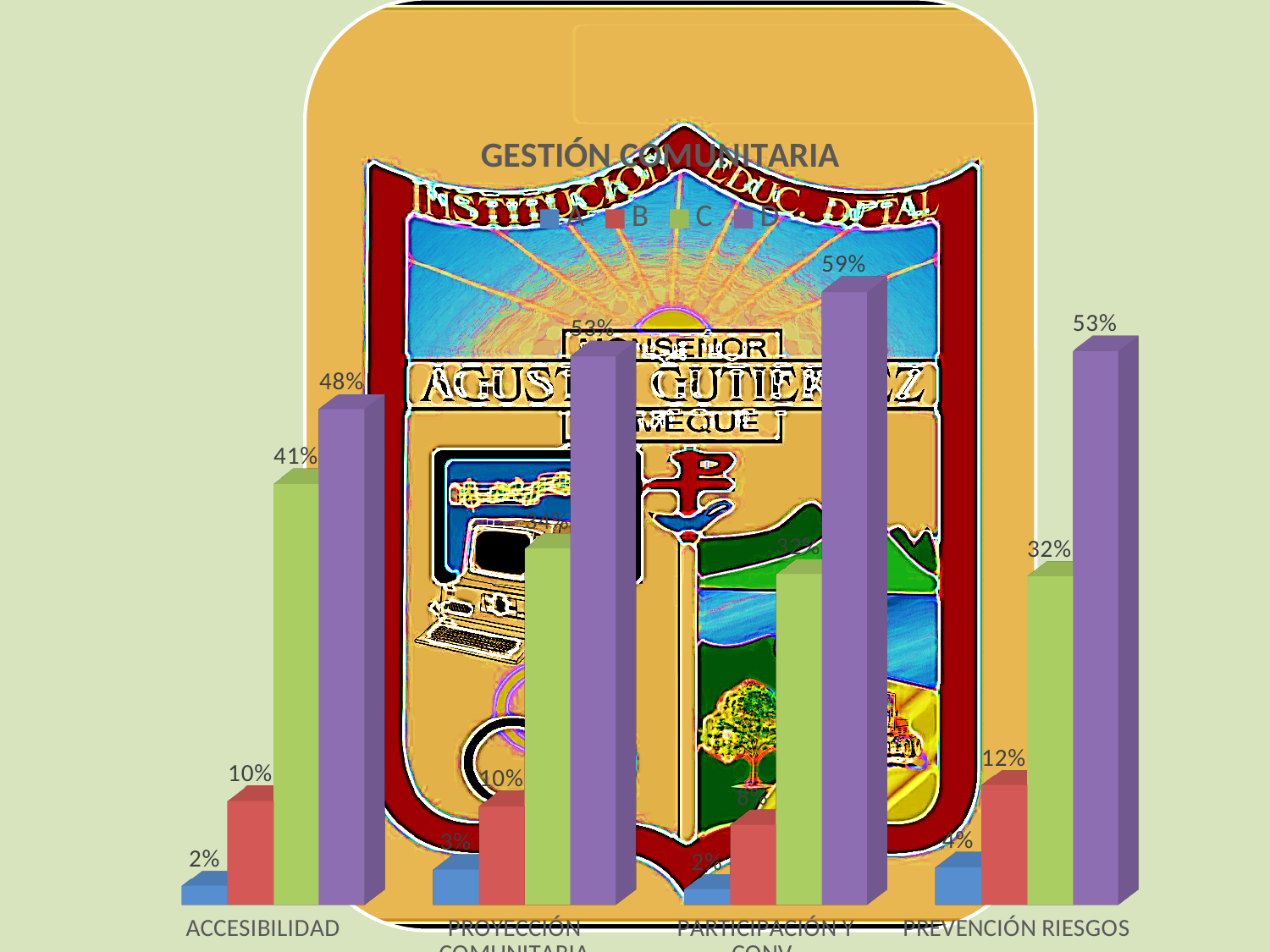
What is the value of series C for ACCESIBILIDAD? 41% What is the title of the chart? GESTIÓN COMUNITARIA What is the difference between series D and series C for ACCESIBILIDAD? 7% Which is larger: series D for ACCESIBILIDAD or series D for PREVENCIÓN RIESGOS? PREVENCIÓN RIESGOS How many categories are shown on the x axis? 4 What is the value of series A for ACCESIBILIDAD? 2% How many series does the legend list? 4 What kind of chart is shown on the slide? bar chart What is the value of series D for ACCESIBILIDAD? 48% What is the value of series B for PREVENCIÓN RIESGOS? 12% What is the value of series D for PARTICIPACIÓN Y CONV? 59% Which category has the highest value for series D? PARTICIPACIÓN Y CONV